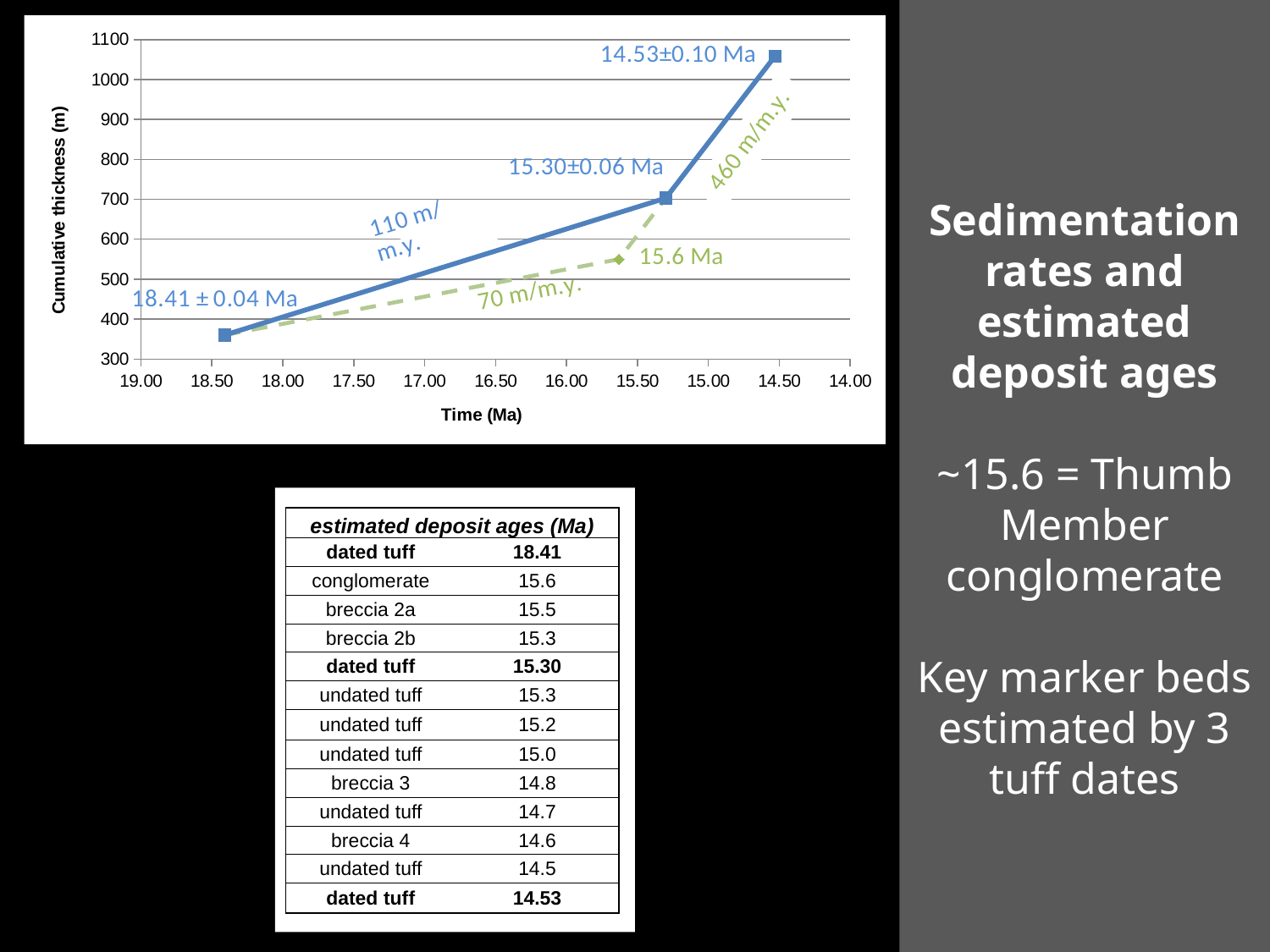
What sedimentation rate is labelled on the green dashed line? 70 m/m.y. What is the label of the vertical axis of the chart? Cumulative thickness (m) Is the cumulative thickness at the 14.53 Ma point greater or less than 1000 m? greater Is the cumulative thickness at the 18.41 Ma point greater or less than 400 m? less How many dated tuff points are plotted on the solid blue line? 3 What sedimentation rate is labelled on the solid line between the 18.41 Ma and 15.30 Ma points? 110 m/m.y. What age is labelled at the end of the green dashed line? 15.6 Ma Which dated point has the lowest cumulative thickness? 18.41 ± 0.04 Ma Which dated point has the highest cumulative thickness? 14.53±0.10 Ma What is the label of the horizontal axis of the chart? Time (Ma) What sedimentation rate is labelled on the solid line between the 15.30 Ma and 14.53 Ma points? 460 m/m.y. What kind of chart is shown on the slide? line chart